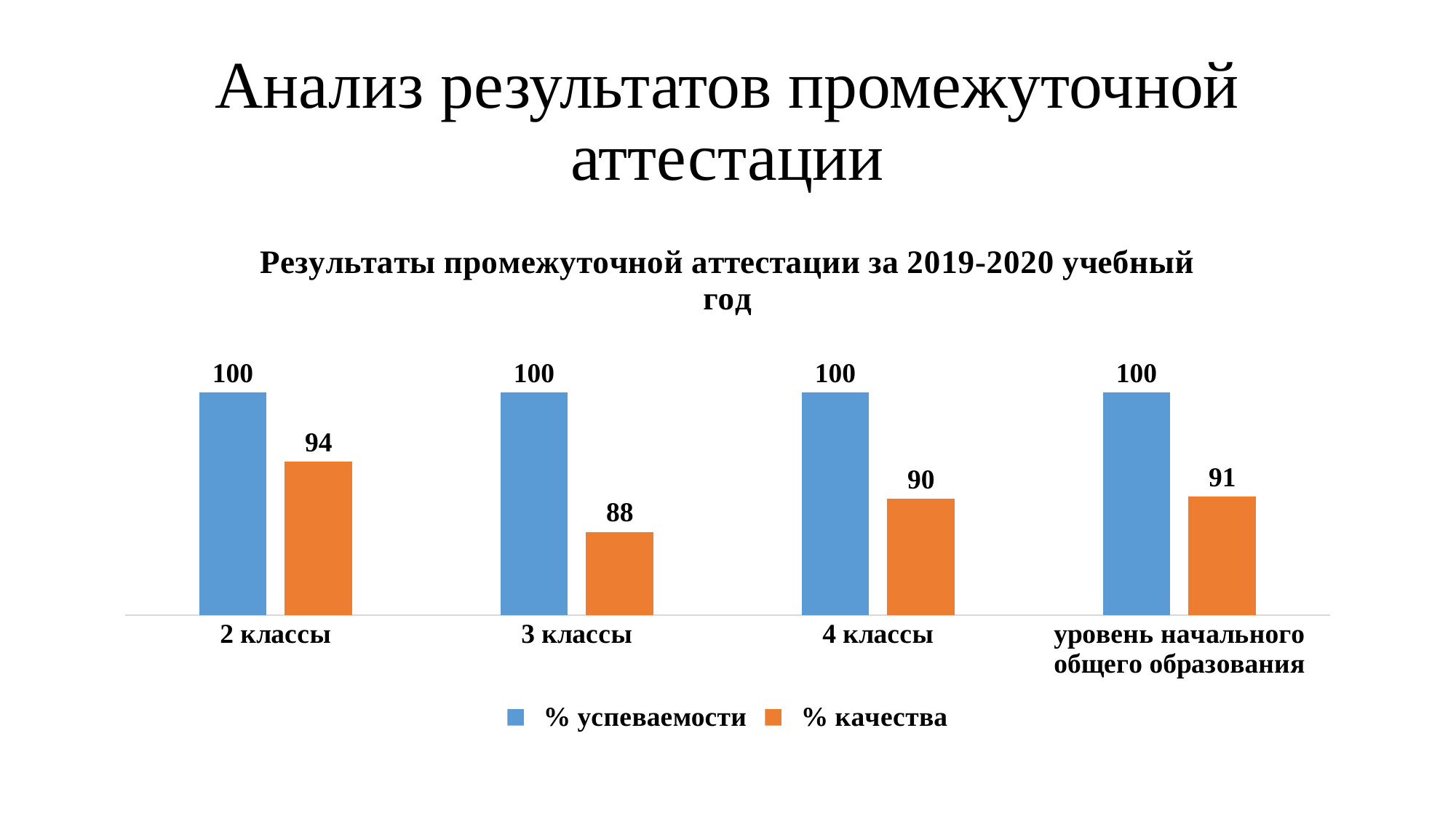
What is the difference between the % успеваемости and % качества values for 3 классы? 12 What is the difference between the % качества values for 2 классы and 4 классы? 4 How many series does the legend list? 2 What is the % качества value for 3 классы? 88 What is the % качества value for 2 классы? 94 Which category has the lowest % качества value? 3 классы What kind of chart is shown on the slide? bar chart Which is larger: the % качества value for 4 классы or for уровень начального общего образования? уровень начального общего образования What is the % качества value for 4 классы? 90 How many categories are shown on the x axis? 4 What is the % успеваемости value for уровень начального общего образования? 100 Which category has the highest % качества value? 2 классы